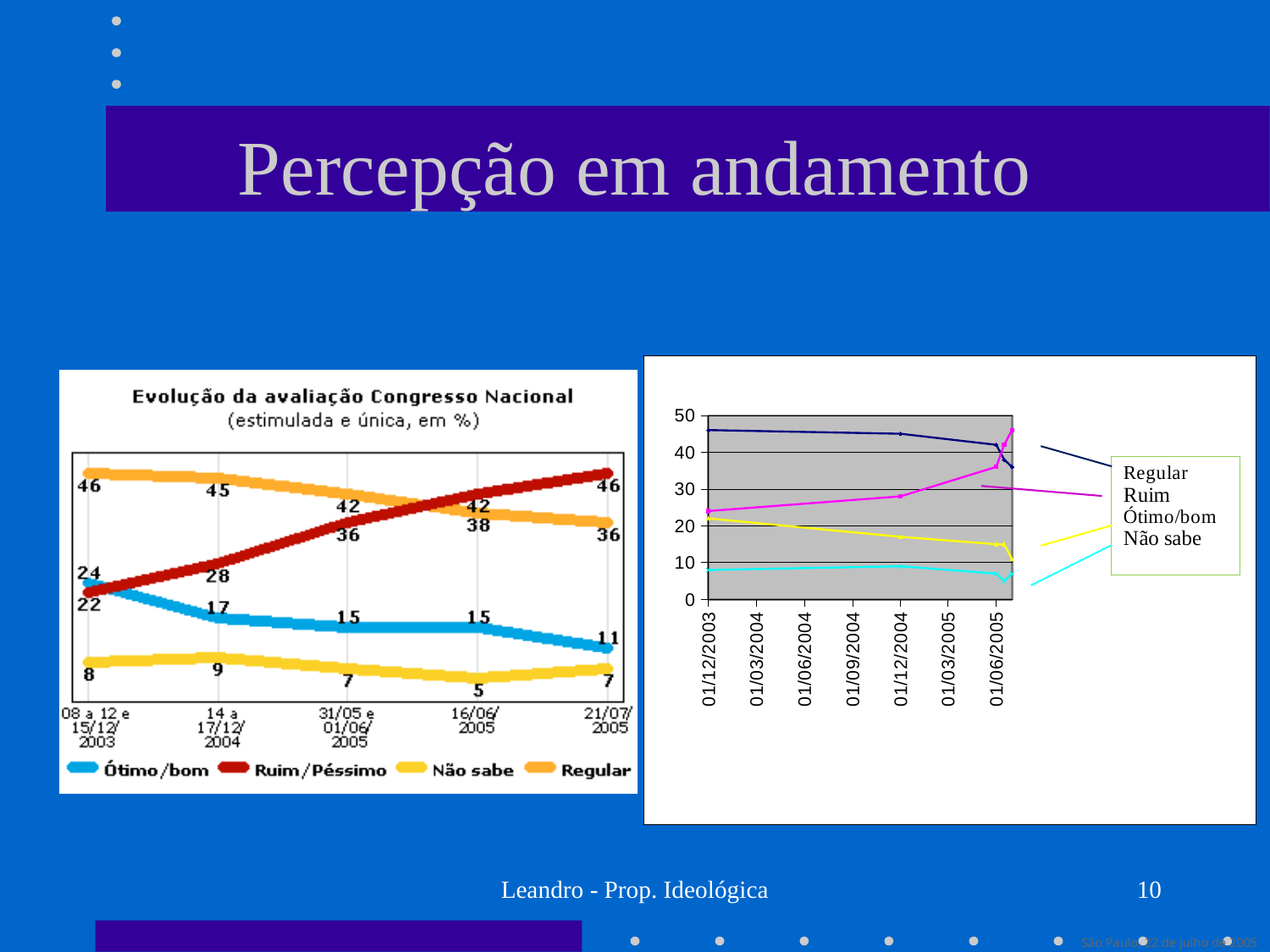
In the left chart 'Evolução da avaliação Congresso Nacional', does the Ruim/Péssimo series rise or fall over time? rise In the left chart 'Evolução da avaliação Congresso Nacional', what is the value for Não sabe on 16/06/2005? 5 In the left chart 'Evolução da avaliação Congresso Nacional', what is the value for Ótimo/bom on 14 a 17/12/2004? 17 How many series does the legend of the left chart 'Evolução da avaliação Congresso Nacional' list? 4 In the left chart 'Evolução da avaliação Congresso Nacional', which series has the lowest value on 21/07/2005? Não sabe In the left chart 'Evolução da avaliação Congresso Nacional', what is the difference between Ruim/Péssimo and Regular on 21/07/2005? 10 In the left chart 'Evolução da avaliação Congresso Nacional', what is the value for Ruim/Péssimo on 21/07/2005? 46 In the right chart, is the value for Regular at 01/12/2003 greater or less than 40? greater In the left chart 'Evolução da avaliação Congresso Nacional', which is larger on 31/05 e 01/06/2005: Regular or Ruim/Péssimo? Regular What kind of chart is the chart on the right side of the slide? line chart In the right chart, is the value for Não sabe at 01/12/2004 greater or less than 20? less In the left chart 'Evolução da avaliação Congresso Nacional', what is the value for Regular at the first date (08 a 12 e 15/12/2003)? 46